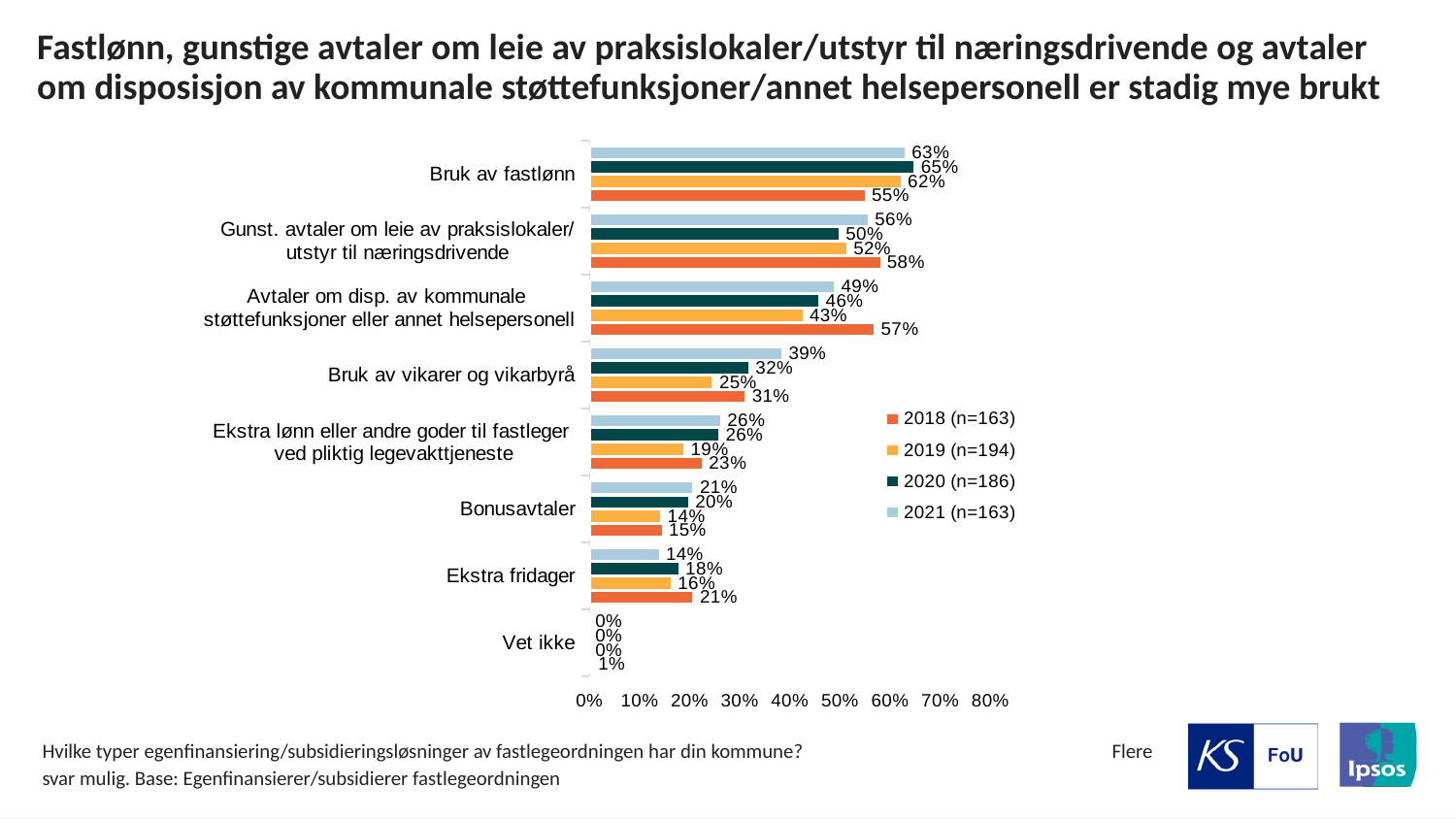
What kind of chart is shown on the slide? Bar chart What is the value for 'Ekstra fridager' in the 2018 (n=163) series? 21% What is the value for 'Bruk av fastlønn' in the 2021 (n=163) series? 63% Which category has the highest value in the 2020 (n=186) series? Bruk av fastlønn How many categories are shown on the chart? 8 For 'Bonusavtaler', which is larger: the 2021 (n=163) value or the 2019 (n=194) value? 2021 (n=163) What is the difference between the 2018 (n=163) and 2019 (n=194) values for 'Avtaler om disp. av kommunale støttefunksjoner eller annet helsepersonell'? 14% What is the value for 'Bruk av vikarer og vikarbyrå' in the 2019 (n=194) series? 25% How many series does the legend list? 4 Is the 2018 (n=163) value for 'Gunst. avtaler om leie av praksislokaler/utstyr til næringsdrivende' greater or less than 50%? greater Which category has the lowest value in the 2021 (n=163) series? Vet ikke